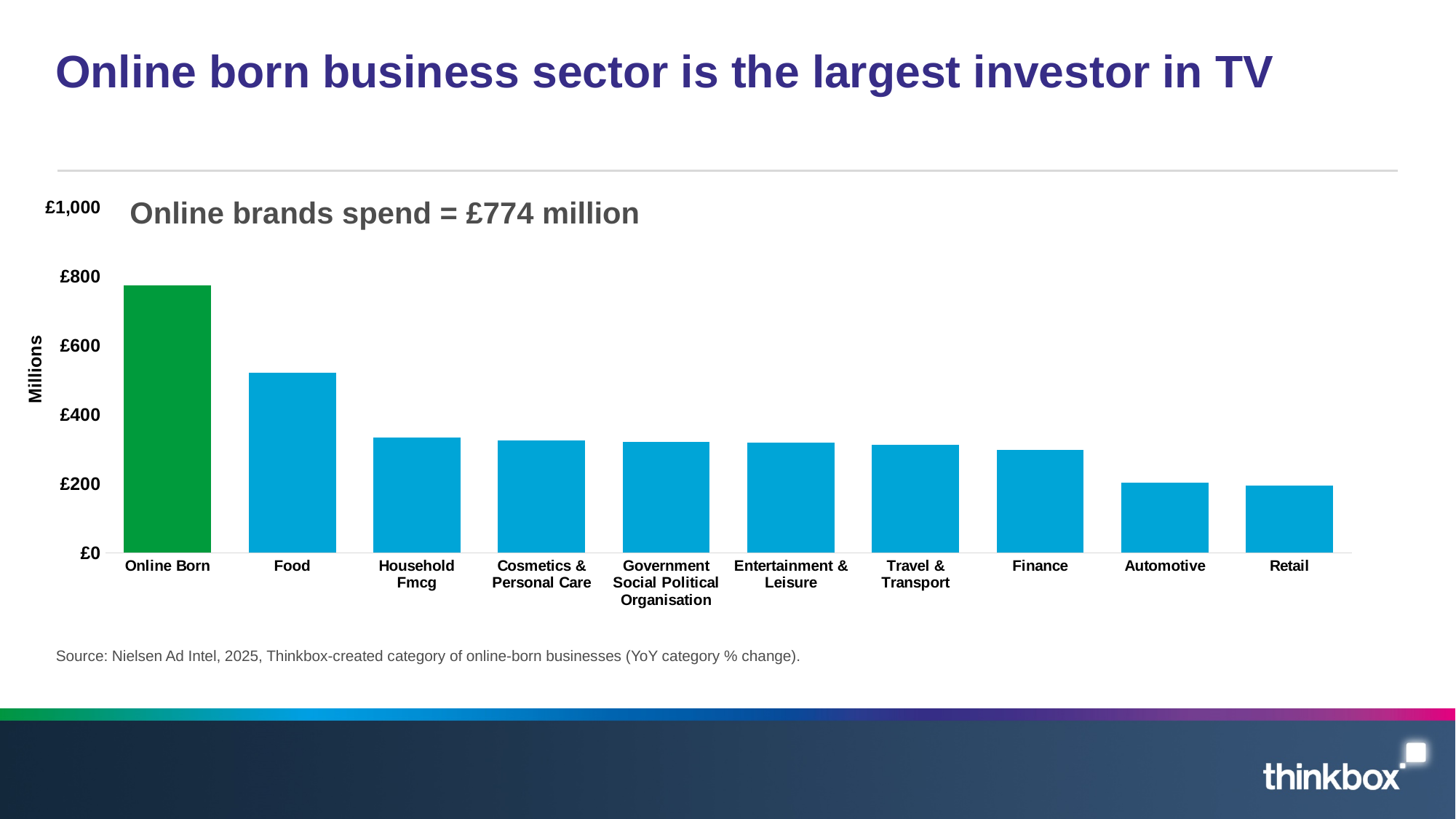
Is the value for Household Fmcg greater or less than £400? less Is the value for Food greater or less than £400? greater Is the value for Food greater or less than £600? less What is the label on the y axis of the chart? Millions Do the bar values generally rise or fall from left to right along the x axis? fall Which has a higher value, Food or Household Fmcg? Food Which sector has the highest TV spend in the chart? Online Born What colour is the Online Born bar? green According to the text on the chart, what is the spend of online brands? £774 million How many business sectors are shown on the x axis of the chart? 10 What kind of chart is shown on the slide? bar chart